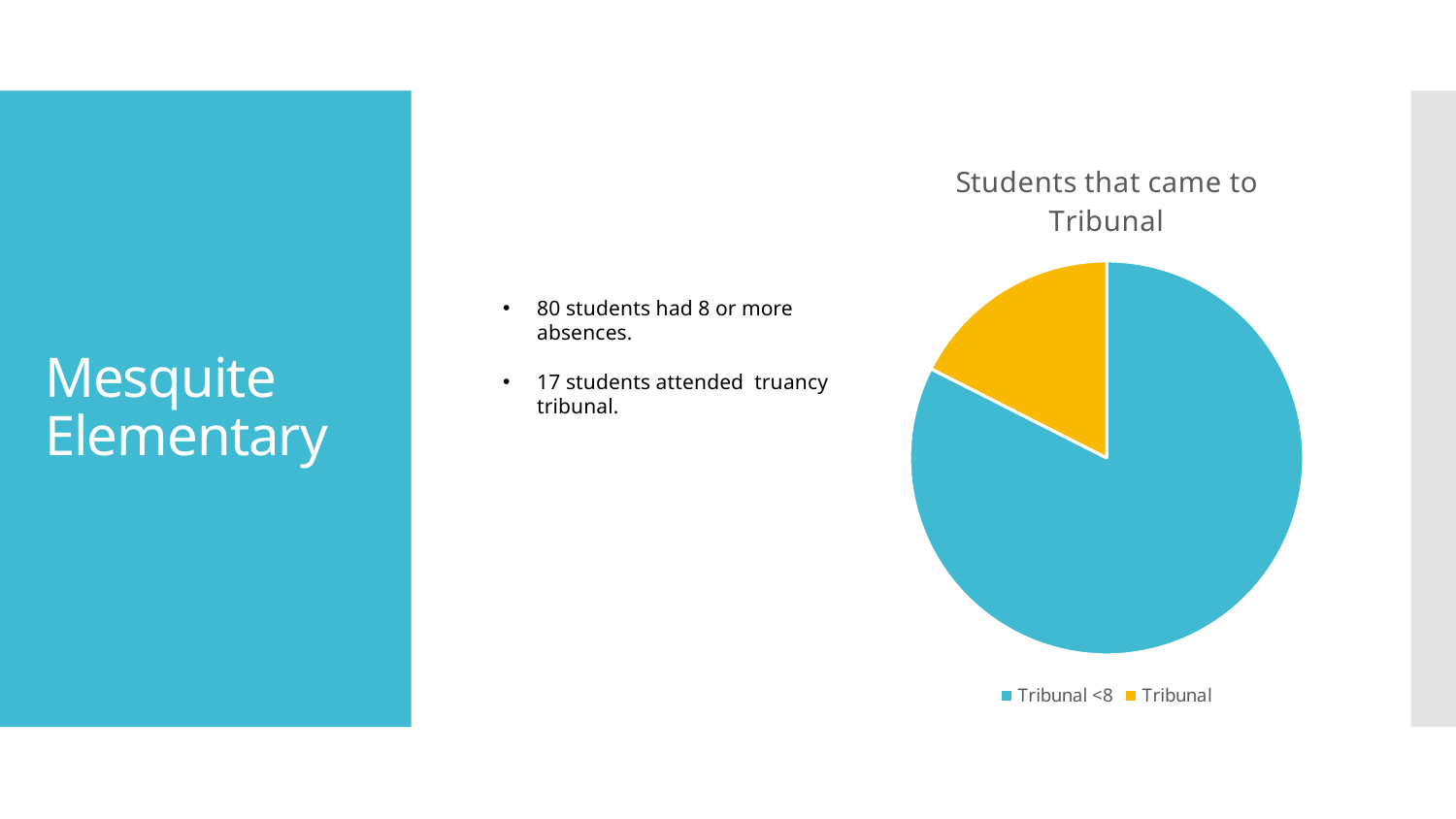
Which slice of the pie chart is the largest? Tribunal <8 Which slice of the pie chart is the smallest? Tribunal In the pie chart, which slice is larger, "Tribunal <8" or "Tribunal"? Tribunal <8 How many slices does the pie chart have? 2 What is the title of the pie chart? Students that came to Tribunal What kind of chart is shown on the slide? pie chart What colour is the "Tribunal" slice in the pie chart? yellow How many entries does the legend of the pie chart list? 2